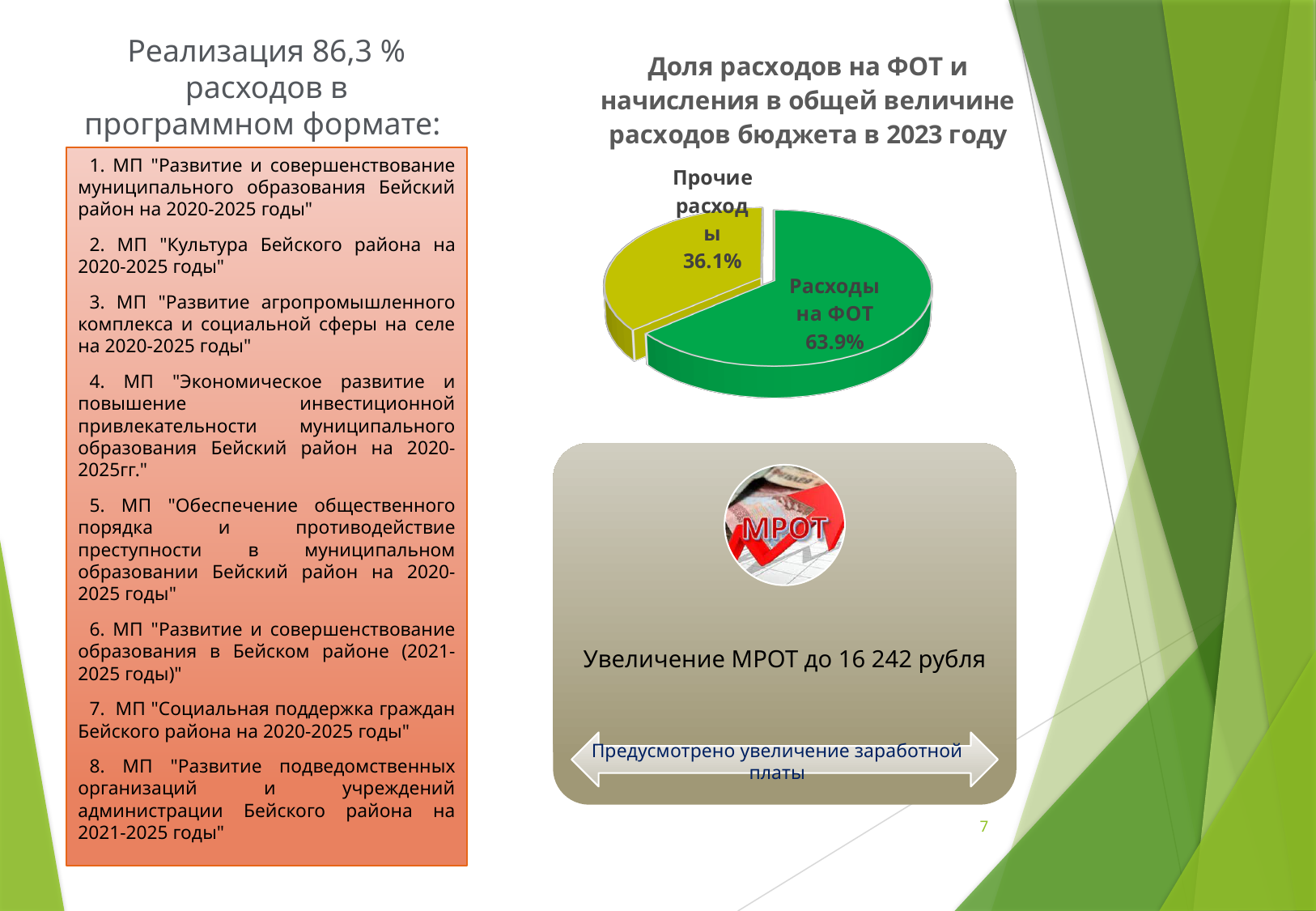
Which slice of the pie chart is the largest? Расходы на ФОТ Which is larger in the pie chart: "Расходы на ФОТ" or "Прочие расходы"? Расходы на ФОТ What is the combined share of the two slices in the pie chart? 100% Is the share for "Прочие расходы" in the pie chart greater or less than 50%? less Which slice of the pie chart is the smallest? Прочие расходы By how many percentage points does "Расходы на ФОТ" exceed "Прочие расходы" in the pie chart? 27.8 percentage points What share of the pie chart is labelled "Расходы на ФОТ"? 63.9% What colour is the "Расходы на ФОТ" slice in the pie chart? Green How many slices does the pie chart have? 2 What is the title of the pie chart? Доля расходов на ФОТ и начисления в общей величине расходов бюджета в 2023 году What type of chart is shown on the slide? Pie chart What share of the pie chart is labelled "Прочие расходы"? 36.1%